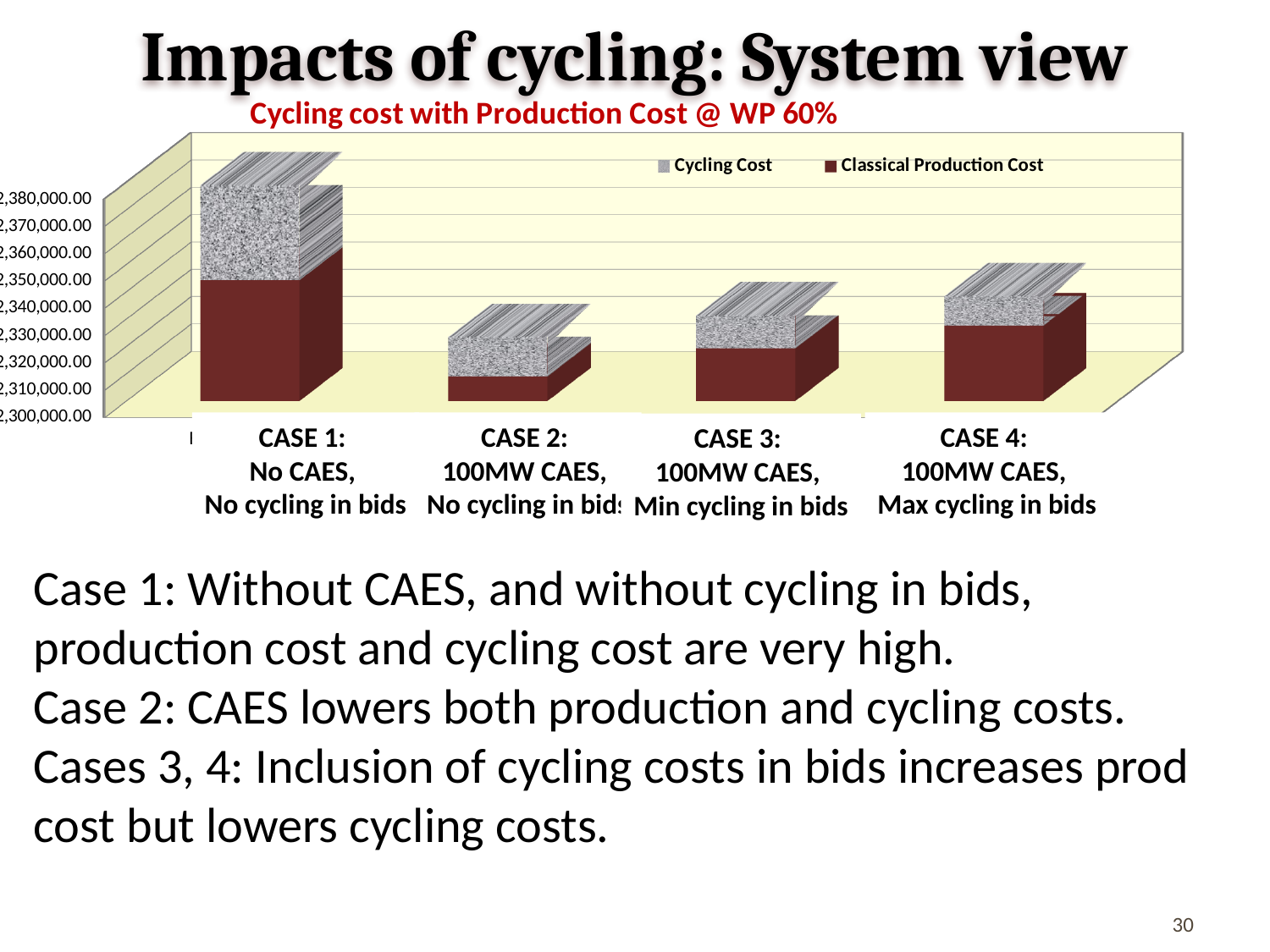
Which case has the lowest total stacked bar? CASE 2: 100MW CAES, No cycling in bids Which case has the highest total stacked bar? CASE 1: No CAES, No cycling in bids Which case has the largest Cycling Cost segment? CASE 1: No CAES, No cycling in bids Is the Classical Production Cost for CASE 4 greater or less than 2,320,000.00? greater Is the Classical Production Cost larger for CASE 4 or for CASE 2? CASE 4 Which case has the lowest Classical Production Cost? CASE 2: 100MW CAES, No cycling in bids Which two series are listed in the chart legend? Cycling Cost and Classical Production Cost How many cases (categories) are plotted on the x axis? 4 What is the title of the chart? Cycling cost with Production Cost @ WP 60% How many series does the chart legend list? 2 Is the Cycling Cost larger for CASE 1 or for CASE 4? CASE 1 What kind of chart is shown on the slide? Stacked bar chart